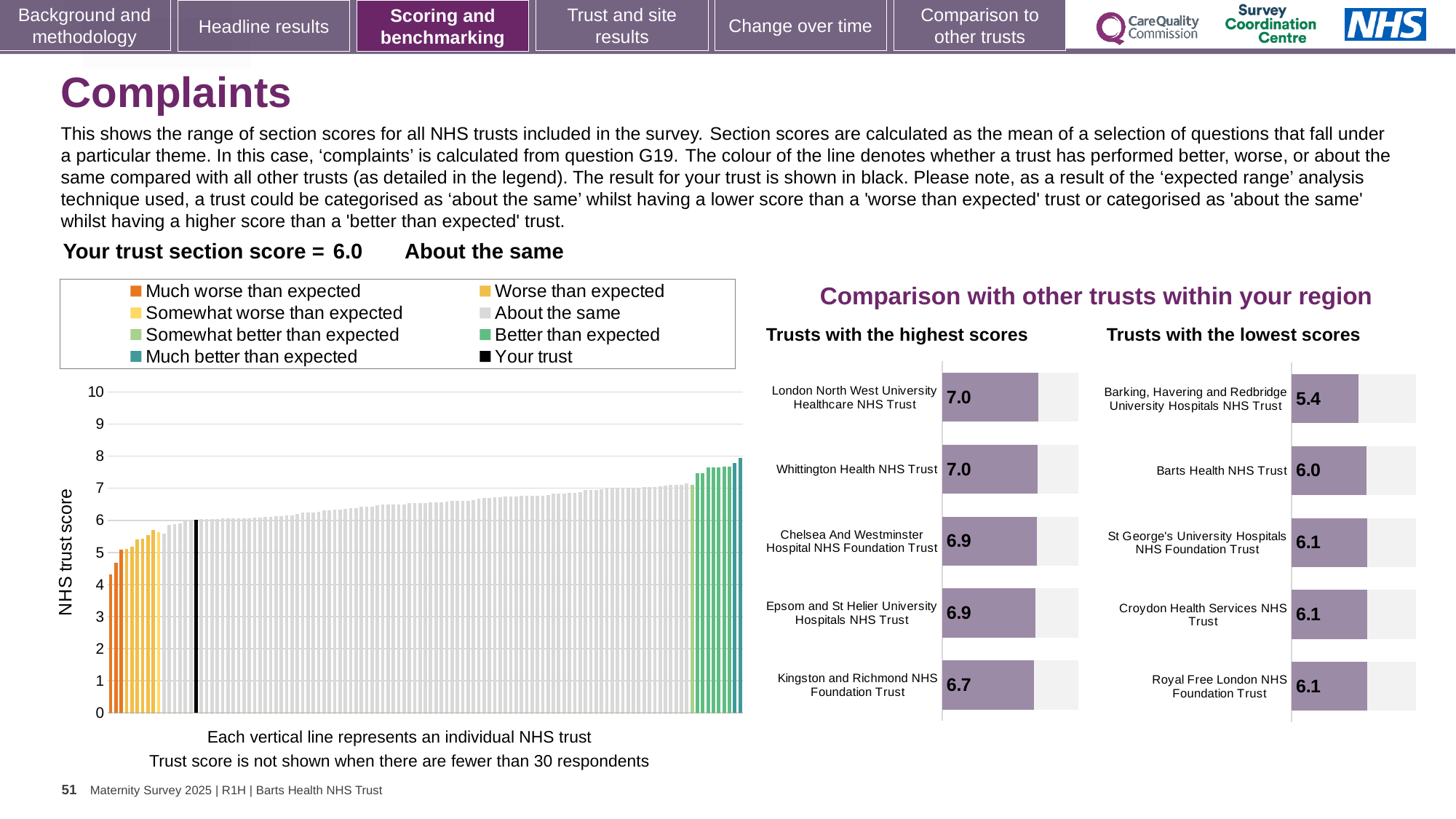
In the 'Trusts with the highest scores' chart, which has the higher score: Chelsea And Westminster Hospital NHS Foundation Trust or Kingston and Richmond NHS Foundation Trust? Chelsea And Westminster Hospital NHS Foundation Trust In the 'Trusts with the lowest scores' chart, which trust has the lowest score? Barking, Havering and Redbridge University Hospitals NHS Trust In the 'Trusts with the lowest scores' chart, what is the score for Barking, Havering and Redbridge University Hospitals NHS Trust? 5.4 In the 'Trusts with the highest scores' chart, what is the score for Kingston and Richmond NHS Foundation Trust? 6.7 In the 'Trusts with the highest scores' chart, which trust has the lowest score? Kingston and Richmond NHS Foundation Trust How many trusts are listed in the 'Trusts with the lowest scores' chart? 5 In the main 'NHS trust score' chart on the left, is the value of the tallest bar greater or less than 7? greater In the 'Trusts with the lowest scores' chart, what is the difference between the scores of Barts Health NHS Trust and Barking, Havering and Redbridge University Hospitals NHS Trust? 0.6 In the 'Trusts with the highest scores' chart, what is the difference between the scores of London North West University Healthcare NHS Trust and Kingston and Richmond NHS Foundation Trust? 0.3 In the main 'NHS trust score' chart on the left, do the bar values rise or fall from left to right? rise In the 'Trusts with the highest scores' chart, what is the score for Chelsea And Westminster Hospital NHS Foundation Trust? 6.9 How many entries does the legend of the main 'NHS trust score' chart on the left list? 8